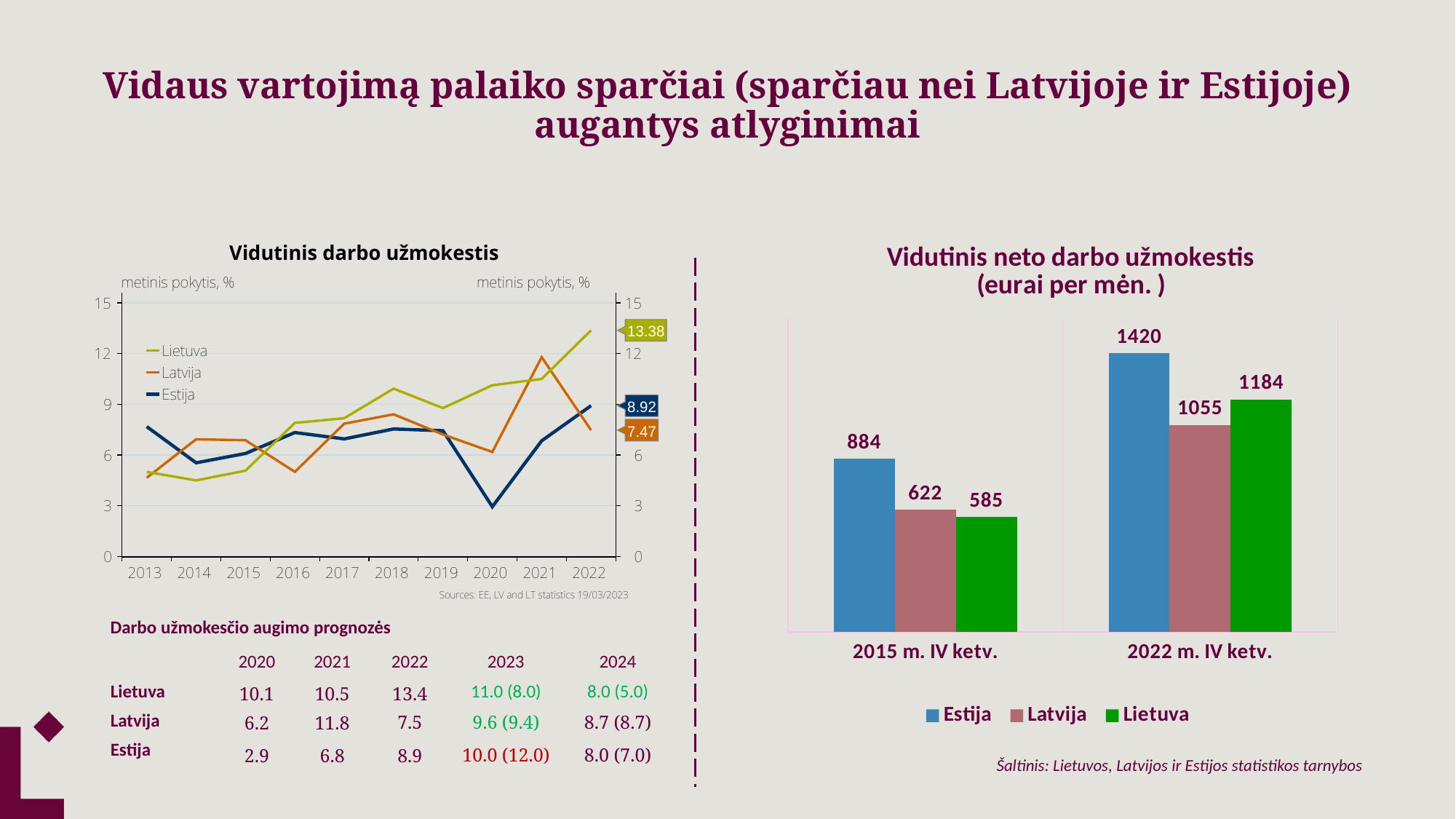
In the 'Vidutinis neto darbo užmokestis' bar chart, what is the difference between Estija and Lietuva in 2022 m. IV ketv.? 236 In the 'Vidutinis neto darbo užmokestis' bar chart, what is the value for Lietuva in 2015 m. IV ketv.? 585 In the 'Vidutinis neto darbo užmokestis' bar chart, is the value for Latvija in 2015 m. IV ketv. larger or smaller than the value for Lietuva in 2015 m. IV ketv.? larger How many years are shown on the x axis of the 'Vidutinis darbo užmokestis' line chart? 10 In the 'Vidutinis neto darbo užmokestis' bar chart, which country has the lowest value in 2022 m. IV ketv.? Latvija In the 'Vidutinis neto darbo užmokestis' bar chart, which country has the highest value in 2015 m. IV ketv.? Estija What kind of chart is 'Vidutinis neto darbo užmokestis'? bar chart In the 'Vidutinis darbo užmokestis' line chart, is the value for Estija in 2020 greater or less than 6? less In the 'Vidutinis darbo užmokestis' line chart, what is the labelled value for Latvija in 2022? 7.47 In the 'Vidutinis darbo užmokestis' line chart, what is the labelled value for Lietuva in 2022? 13.38 How many series does the legend of the 'Vidutinis neto darbo užmokestis' chart list? 3 In the 'Vidutinis neto darbo užmokestis' bar chart, what is the value for Estija in 2022 m. IV ketv.? 1420